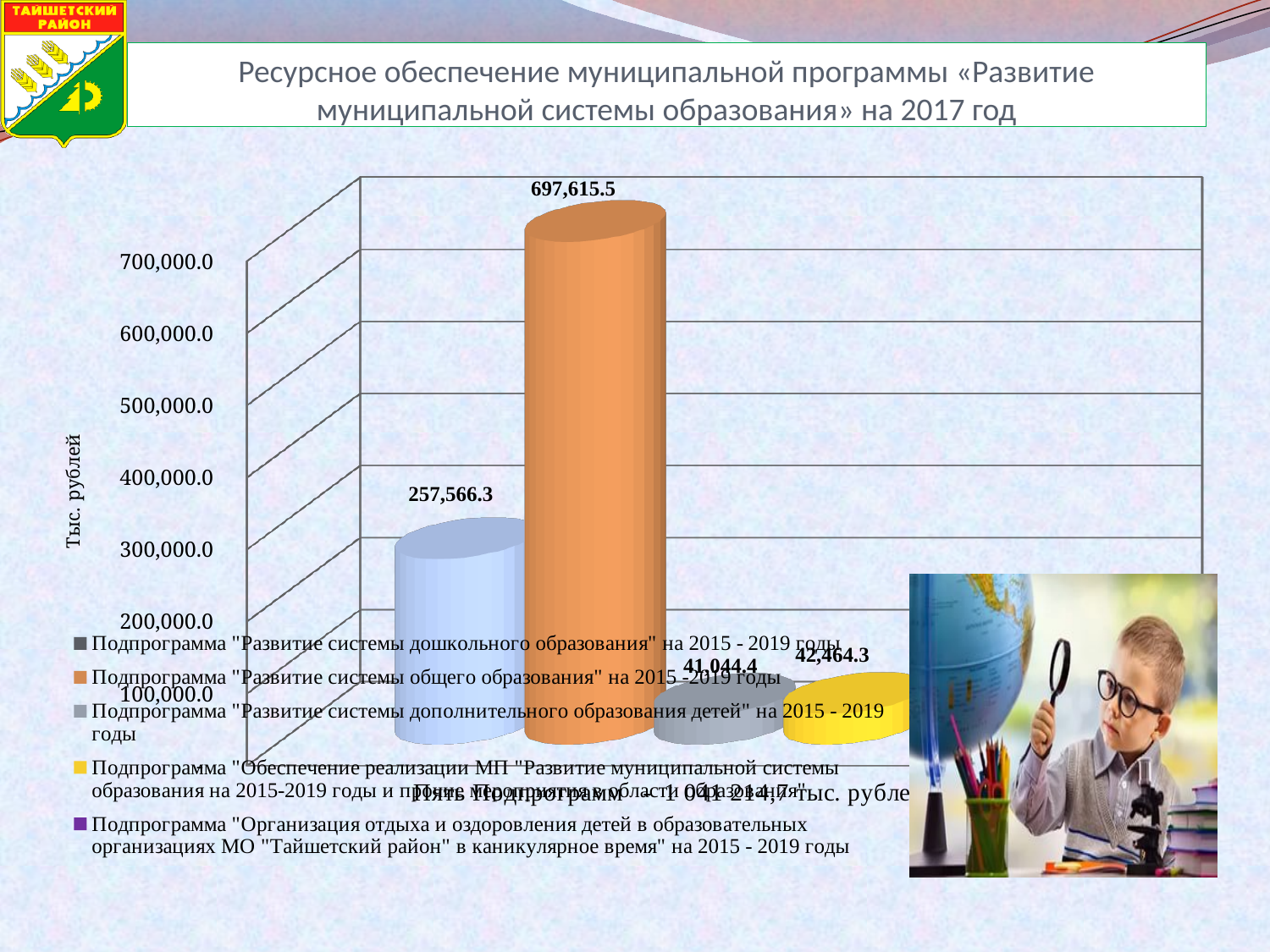
What is the difference between the values for "Развитие системы общего образования" and "Развитие системы дошкольного образования"? 440,049.2 What is the value for the subprogram "Развитие системы дошкольного образования" на 2015-2019 годы? 257,566.3 What is the value for the subprogram "Обеспечение реализации МП "Развитие муниципальной системы образования на 2015-2019 годы и прочие мероприятия в области образования"? 42,464.3 Which is larger: the value for "Развитие системы дошкольного образования" or for "Развитие системы дополнительного образования детей"? Развитие системы дошкольного образования What is the difference between the values for "Обеспечение реализации МП" and "Развитие системы дополнительного образования детей"? 1,419.9 What is the value for the subprogram "Развитие системы дополнительного образования детей" на 2015-2019 годы? 41,044.4 How many series does the legend list? 5 What is the value for the subprogram "Развитие системы общего образования" на 2015-2019 годы? 697,615.5 What kind of chart is shown on the slide? bar chart Is the value for "Развитие системы общего образования" greater or less than 600,000.0? greater What is the label of the vertical axis? Тыс. рублей Which subprogram has the highest value on the chart? Подпрограмма "Развитие системы общего образования" на 2015-2019 годы